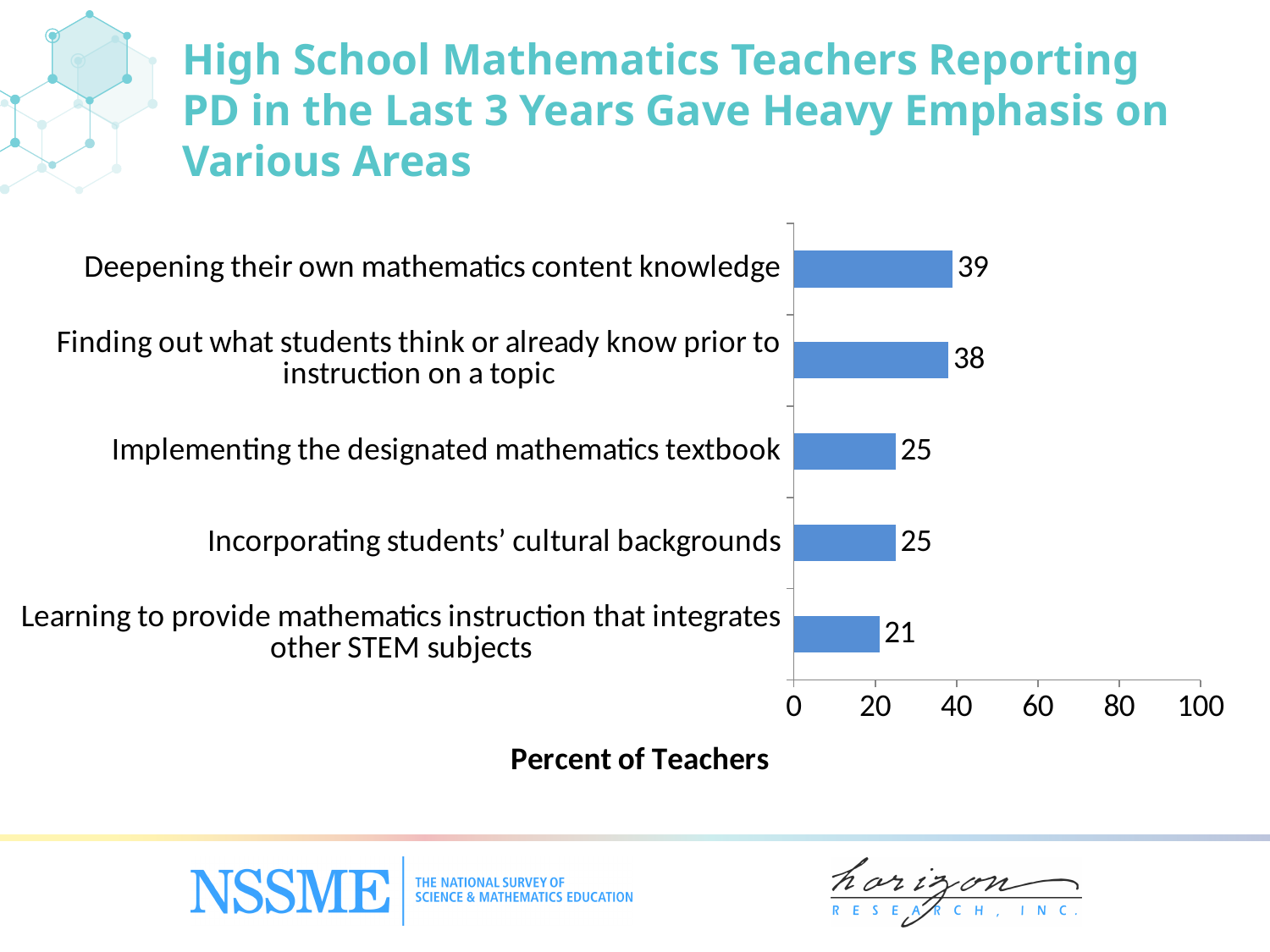
What kind of chart is shown on the slide? Bar chart Which area has the highest percent of teachers? Deepening their own mathematics content knowledge Is the value for 'Finding out what students think or already know prior to instruction on a topic' greater or less than 40? less Which area has the lowest percent of teachers? Learning to provide mathematics instruction that integrates other STEM subjects How many areas are shown in the chart? 5 What is the maximum value shown on the horizontal axis? 100 What is the value for 'Learning to provide mathematics instruction that integrates other STEM subjects'? 21 What is the label of the horizontal axis? Percent of Teachers What is the difference between the values for 'Deepening their own mathematics content knowledge' and 'Learning to provide mathematics instruction that integrates other STEM subjects'? 18 Which is larger: the value for 'Finding out what students think or already know prior to instruction on a topic' or the value for 'Incorporating students' cultural backgrounds'? Finding out what students think or already know prior to instruction on a topic What is the value for 'Implementing the designated mathematics textbook'? 25 What percent of teachers reported heavy emphasis on deepening their own mathematics content knowledge? 39